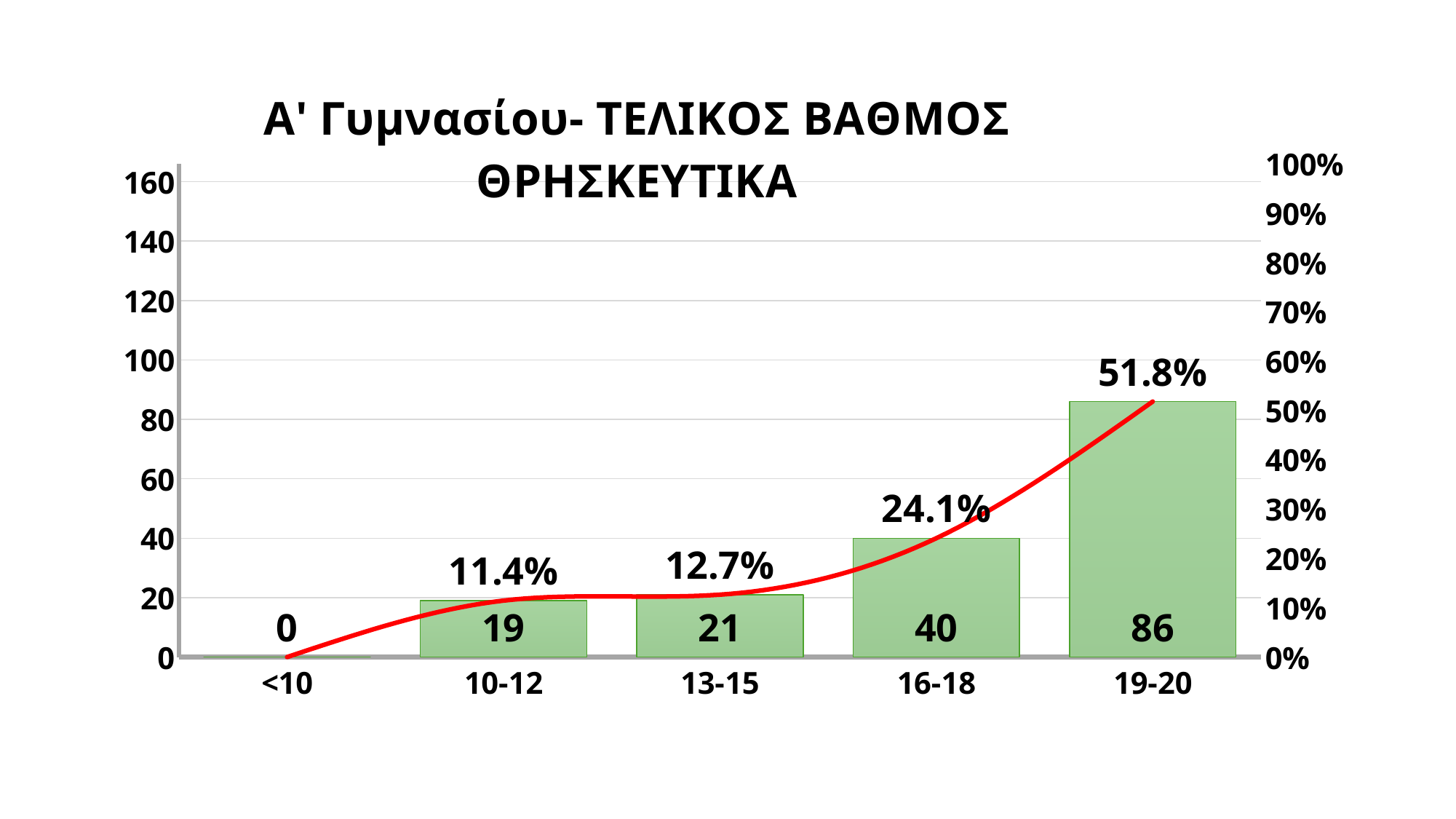
How many categories are shown on the x axis? 5 What is the title of the chart? Α' Γυμνασίου- ΤΕΛΙΚΟΣ ΒΑΘΜΟΣ ΘΡΗΣΚΕΥΤΙΚΑ Which category has the lowest bar value? <10 What is the bar value for the 19-20 category? 86 Which category has the highest bar value? 19-20 What kind of chart is this? Combined bar and line chart What percentage is labelled on the line for the 16-18 category? 24.1% Which has a larger bar value, 10-12 or 16-18? 16-18 What is the difference between the bar values for 19-20 and 16-18? 46 What percentage is labelled on the line for the 10-12 category? 11.4% Do the bar values rise or fall from left to right along the x axis? Rise What is the bar value for the 13-15 category? 21